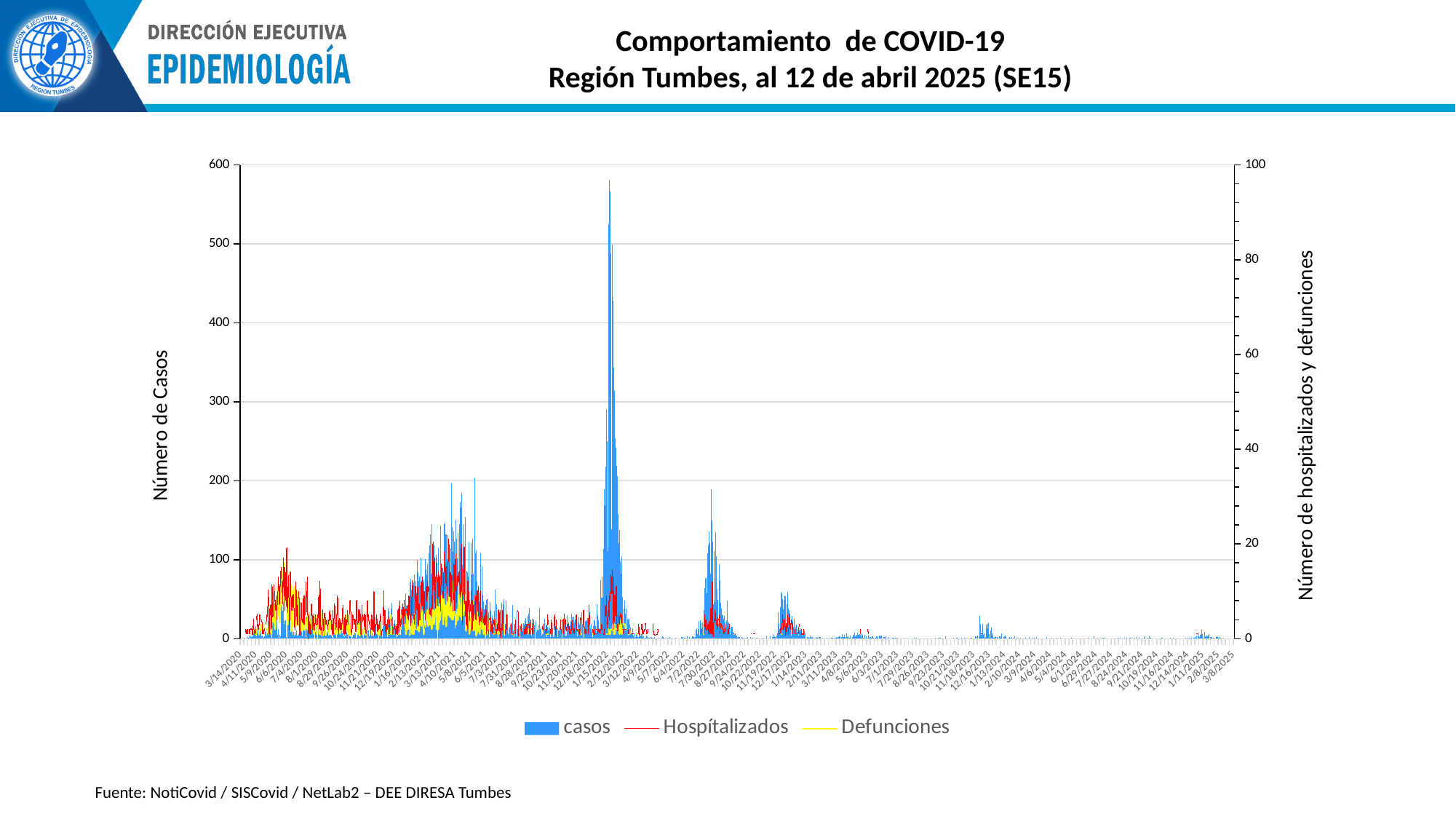
Is the peak of casos around 12/17/2022 greater or less than 100? less How many series does the legend list? 3 What is the label of the left vertical axis? Número de Casos What is the title of the chart? Comportamiento de COVID-19 Región Tumbes, al 12 de abril 2025 (SE15) What is the maximum value shown on the right vertical axis? 100 Which series is plotted as blue bars? casos Is the highest peak of the casos series greater or less than 500? greater What is the maximum value shown on the left vertical axis? 600 Is the peak of casos around 7/30/2022 greater or less than 300? less Do the casos values generally rise or fall from early 2022 to 2025? fall